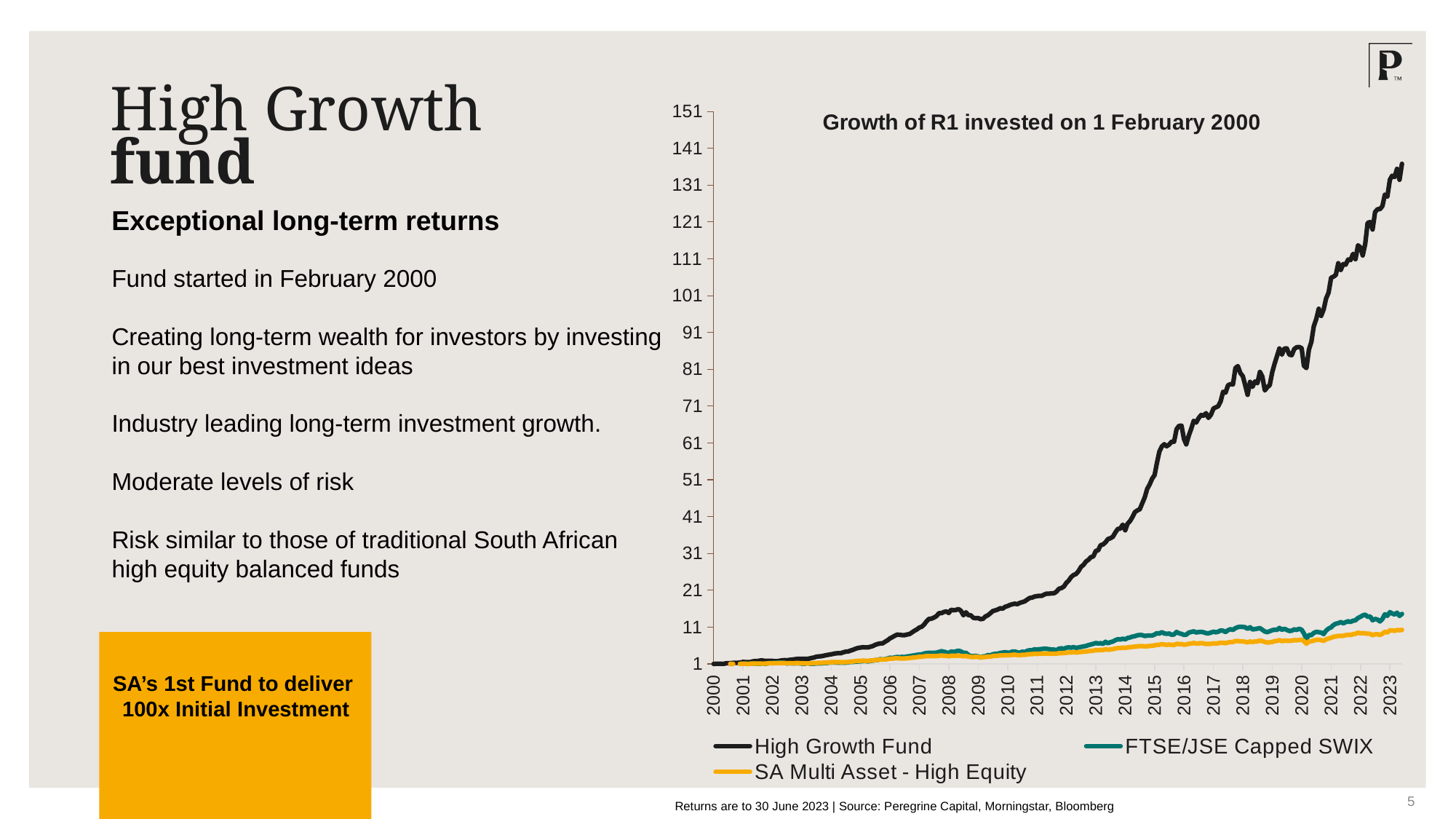
Is the value of the High Growth Fund in 2015 greater or less than 41? greater Is the value of the High Growth Fund in 2023 greater or less than 121? greater What is the title of the chart? Growth of R1 invested on 1 February 2000 How many year labels are shown on the x axis? 24 Which series has the highest value at the end of the chart in 2023? High Growth Fund Does the High Growth Fund line generally rise or fall from 2000 to 2023? Rise Which series is plotted with a black line? High Growth Fund Is the value of the FTSE/JSE Capped SWIX in 2023 greater or less than 21? less Which is larger in 2023, the High Growth Fund or the SA Multi Asset - High Equity series? High Growth Fund Which series has the lowest value at the end of the chart in 2023? SA Multi Asset - High Equity What kind of chart is shown on the slide? Line chart How many series does the chart legend list? 3